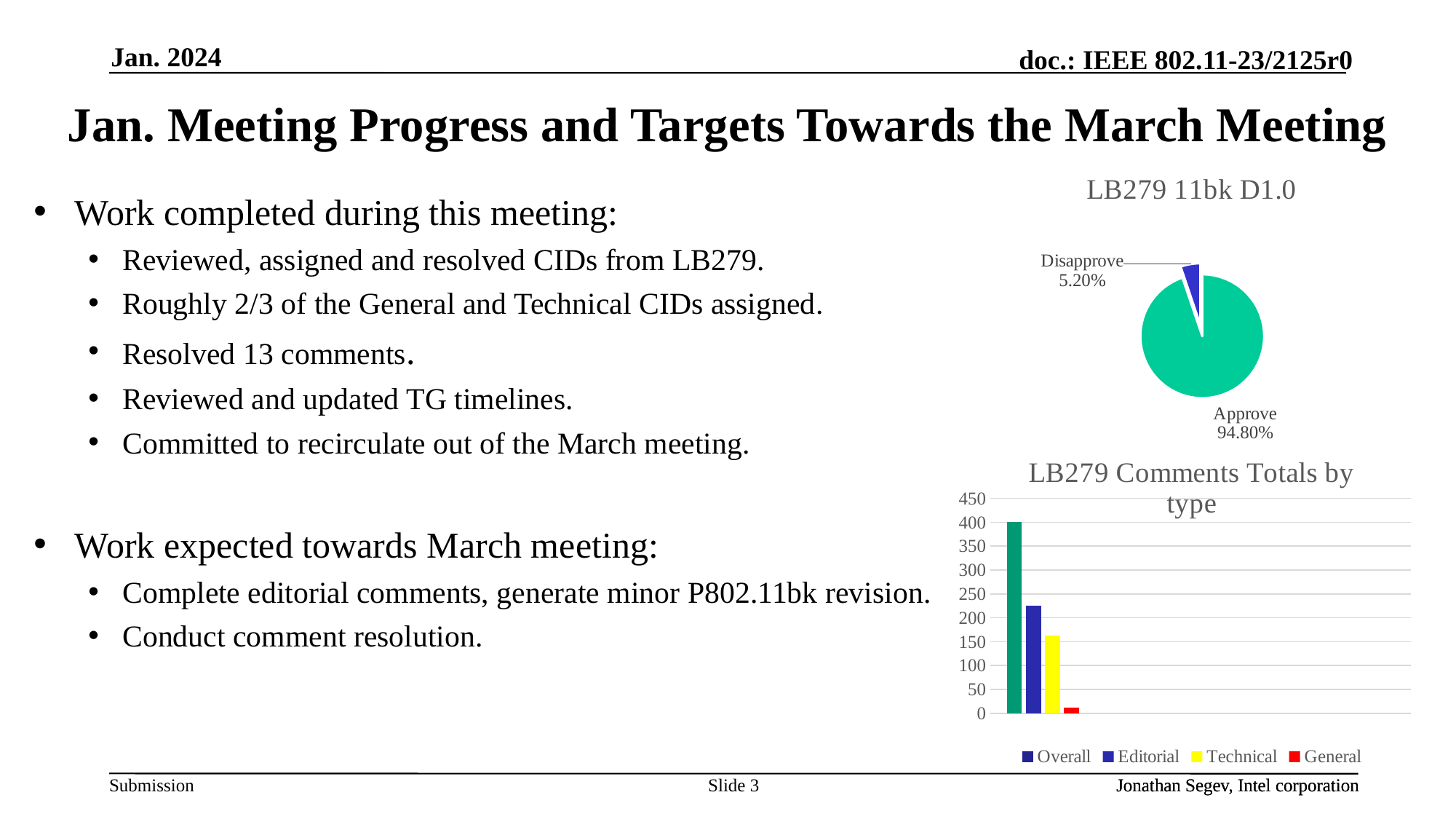
In the chart titled "LB279 Comments Totals by type", which series has the lowest bar? General In the pie chart titled "LB279 11bk D1.0", what share is labelled Disapprove? 5.20% In the pie chart titled "LB279 11bk D1.0", which slice is larger, Approve or Disapprove? Approve In the pie chart titled "LB279 11bk D1.0", what share is labelled Approve? 94.80% In the pie chart titled "LB279 11bk D1.0", how many slices are shown? 2 In the chart titled "LB279 Comments Totals by type", how many series does the legend list? 4 In the chart titled "LB279 Comments Totals by type", which is larger, Editorial or Technical? Editorial What kind of chart is the upper chart titled "LB279 11bk D1.0"? pie chart What kind of chart is the lower chart titled "LB279 Comments Totals by type"? bar chart In the chart titled "LB279 Comments Totals by type", is the value for Technical greater or less than 200? less In the chart titled "LB279 Comments Totals by type", which series has the highest bar? Overall In the chart titled "LB279 Comments Totals by type", is the value for Editorial greater or less than 200? greater